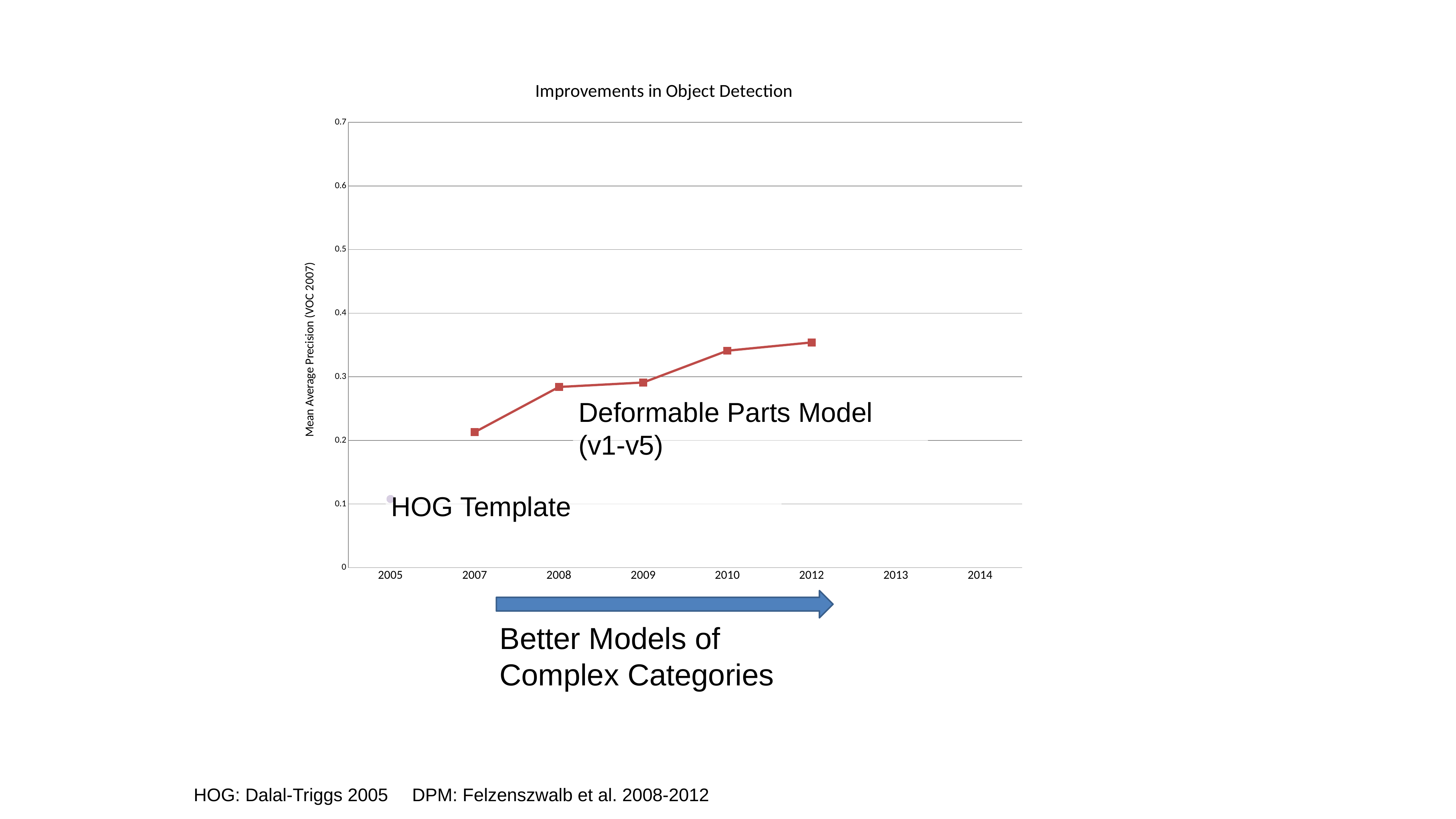
Which is larger, the value for 2010 or the value for 2008? 2010 Which year has the lowest value on the red line? 2007 How many year labels are shown on the x axis? 8 Is the value for 2007 greater or less than 0.3? less Which year has the highest value on the red line? 2012 What kind of chart is shown on the slide? line chart What is the label of the vertical axis? Mean Average Precision (VOC 2007) Is the value for 2010 greater or less than 0.4? less What is the title of the chart? Improvements in Object Detection Is the value for 2008 greater or less than 0.3? less Does the red line rise or fall from 2007 to 2012? rise